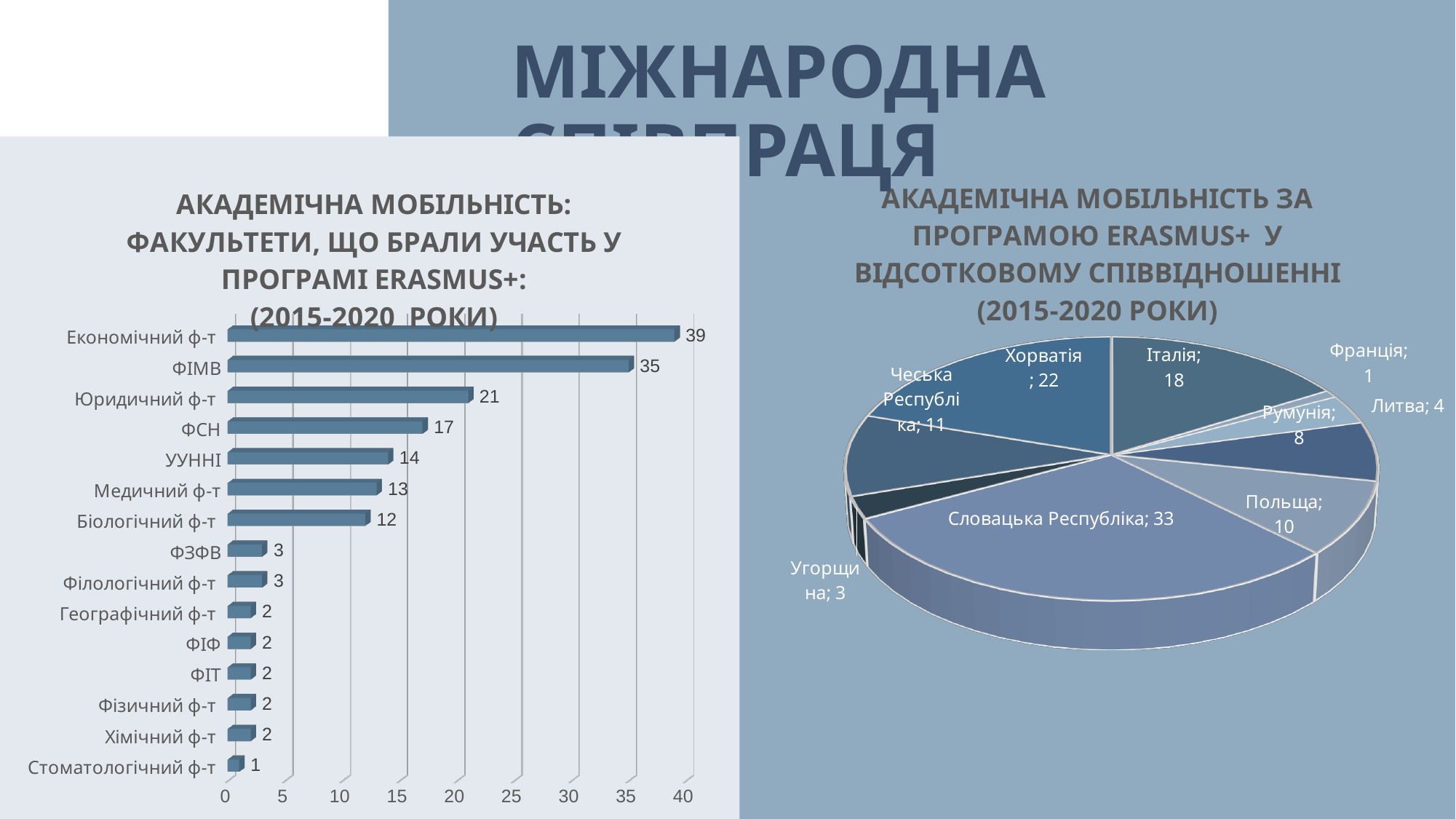
On the bar chart on the left, how many faculties are shown? 15 On the pie chart on the right, which country has the smallest slice? Франція On the bar chart on the left, what is the difference between the values for Економічний ф-т and ФІМВ? 4 On the bar chart on the left, which faculty has the lowest value? Стоматологічний ф-т On the pie chart on the right, what is the value for Румунія? 8 On the bar chart on the left, what is the value for Економічний ф-т? 39 On the pie chart on the right, what is the value for Словацька Республіка? 33 On the bar chart on the left, which is larger: the value for ФСН or the value for УУННІ? ФСН What kind of chart is the chart on the right of the slide? pie chart On the pie chart on the right, what is the difference between the values for Хорватія and Італія? 4 What kind of chart is the chart on the left of the slide? bar chart On the bar chart on the left, what is the value for Юридичний ф-т? 21